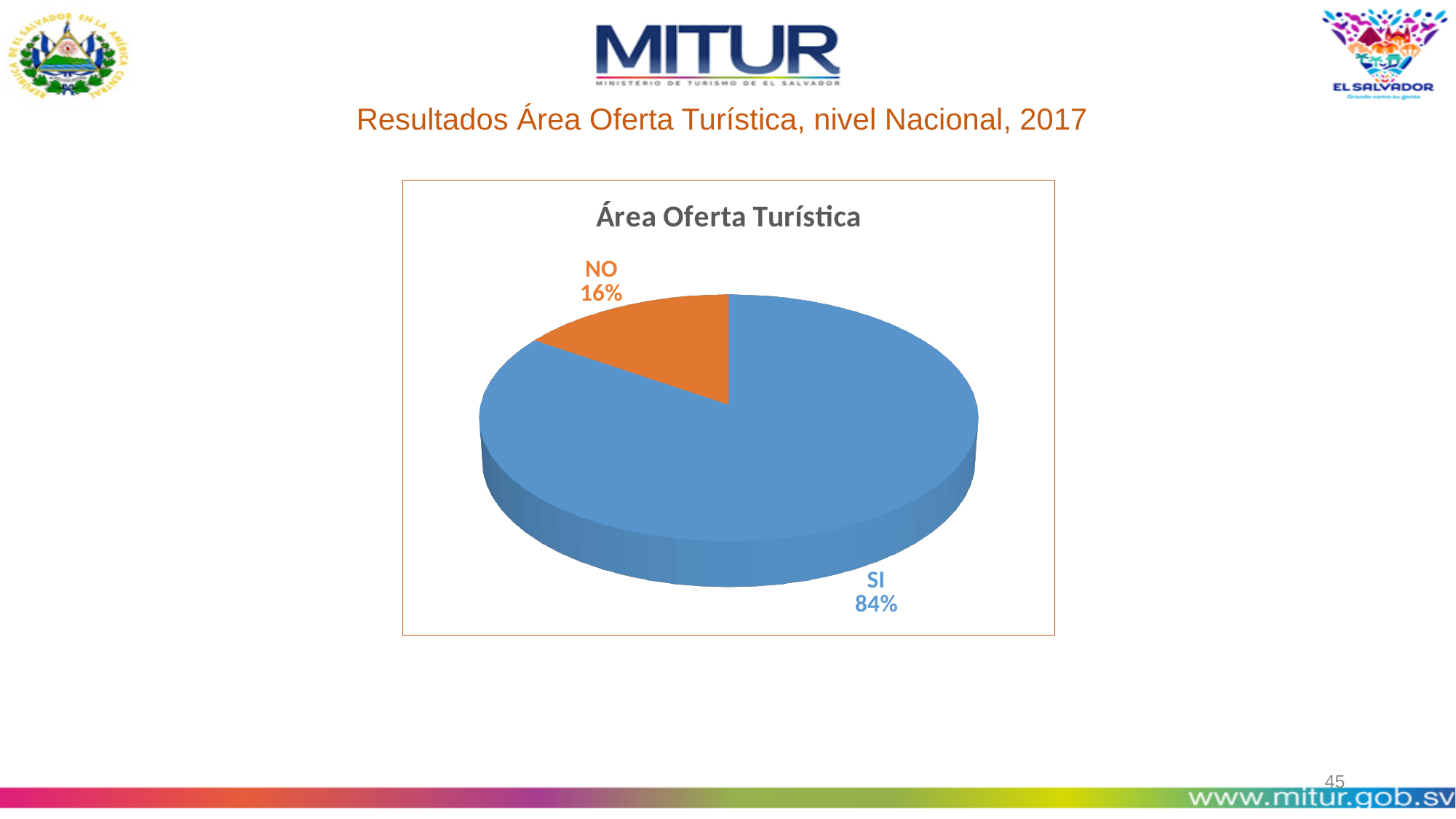
What percentage of the pie chart is labelled SI? 84% Which slice of the pie chart is the largest? SI What share of the pie does the NO slice represent? 16% What percentage of the pie chart is labelled NO? 16% What type of chart is shown on the slide? Pie chart Which is larger, the SI slice or the NO slice? SI Which slice of the pie chart is the smallest? NO What colour is the SI slice of the pie chart? Blue What is the difference in percentage points between the SI and NO slices? 68 How many slices does the pie chart have? 2 What is the title of the chart? Área Oferta Turística